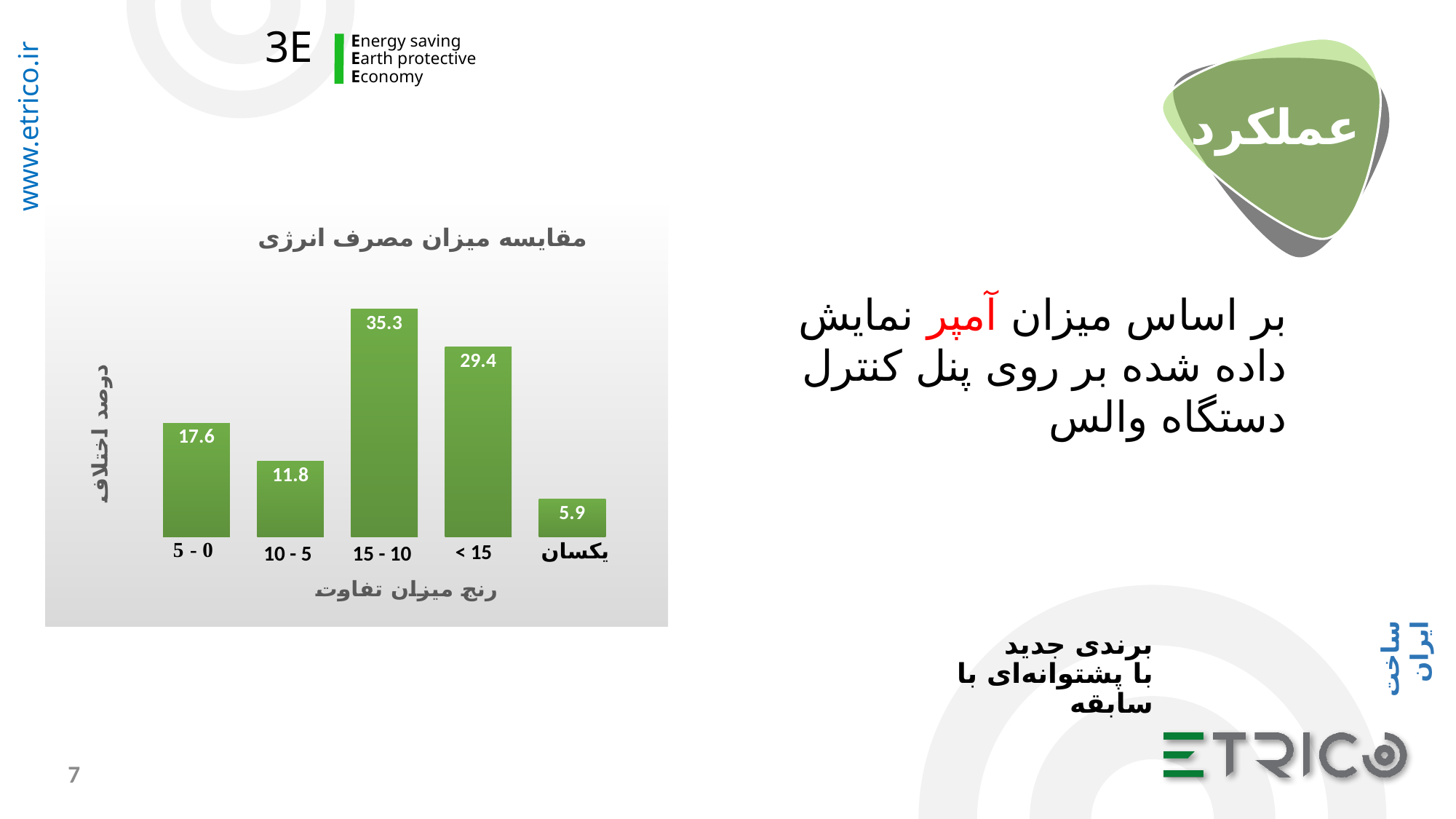
What is the title of the chart? مقایسه میزان مصرف انرژی What is the difference between the values for "15 - 10" and "< 15"? 5.9 What type of chart is shown on the slide? bar chart Which is larger, the value for "5 - 0" or the value for "10 - 5"? 5 - 0 What is the value for the category "5 - 0"? 17.6 What is the value for the category "< 15"? 29.4 How many categories are shown on the x axis? 5 What is the value for the category "یکسان"? 5.9 What is the label of the vertical axis? درصد اختلاف Which category has the lowest value? یکسان Which category has the highest value? 15 - 10 What is the value for the category "15 - 10"? 35.3